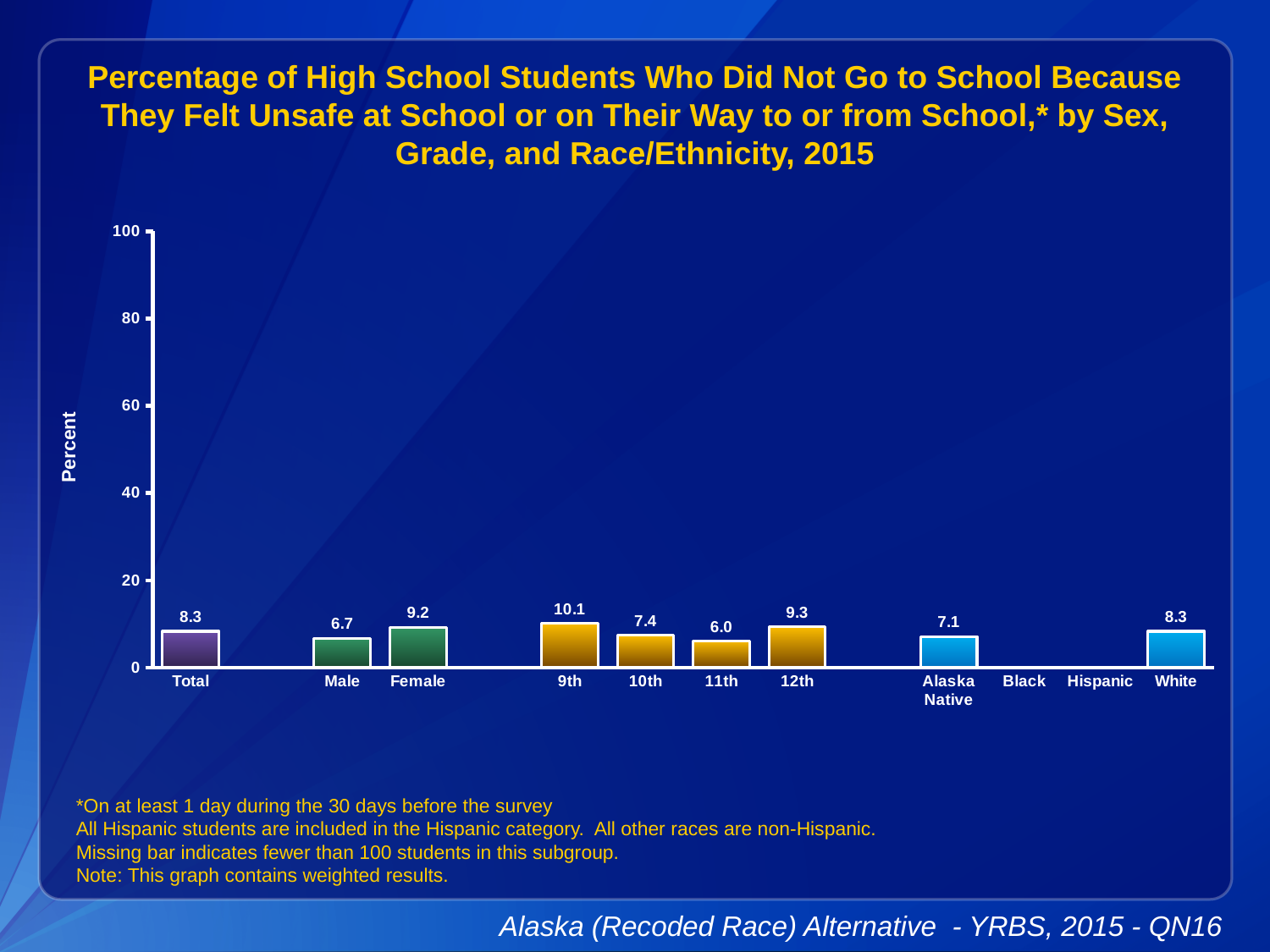
Which is larger, the value for 12th grade or the value for 10th grade? 12th What is the value for Total? 8.3 What is the value for Alaska Native? 7.1 Which category with a bar has the lowest value? 11th What kind of chart is shown? bar chart What is the value for 11th grade? 6.0 How many categories have a bar shown? 9 What is the value for Female? 9.2 What is the difference between the Female and Male values? 2.5 Is the value for 9th grade greater or less than 20? less Which categories have no bar shown? Black and Hispanic Which category has the highest value? 9th